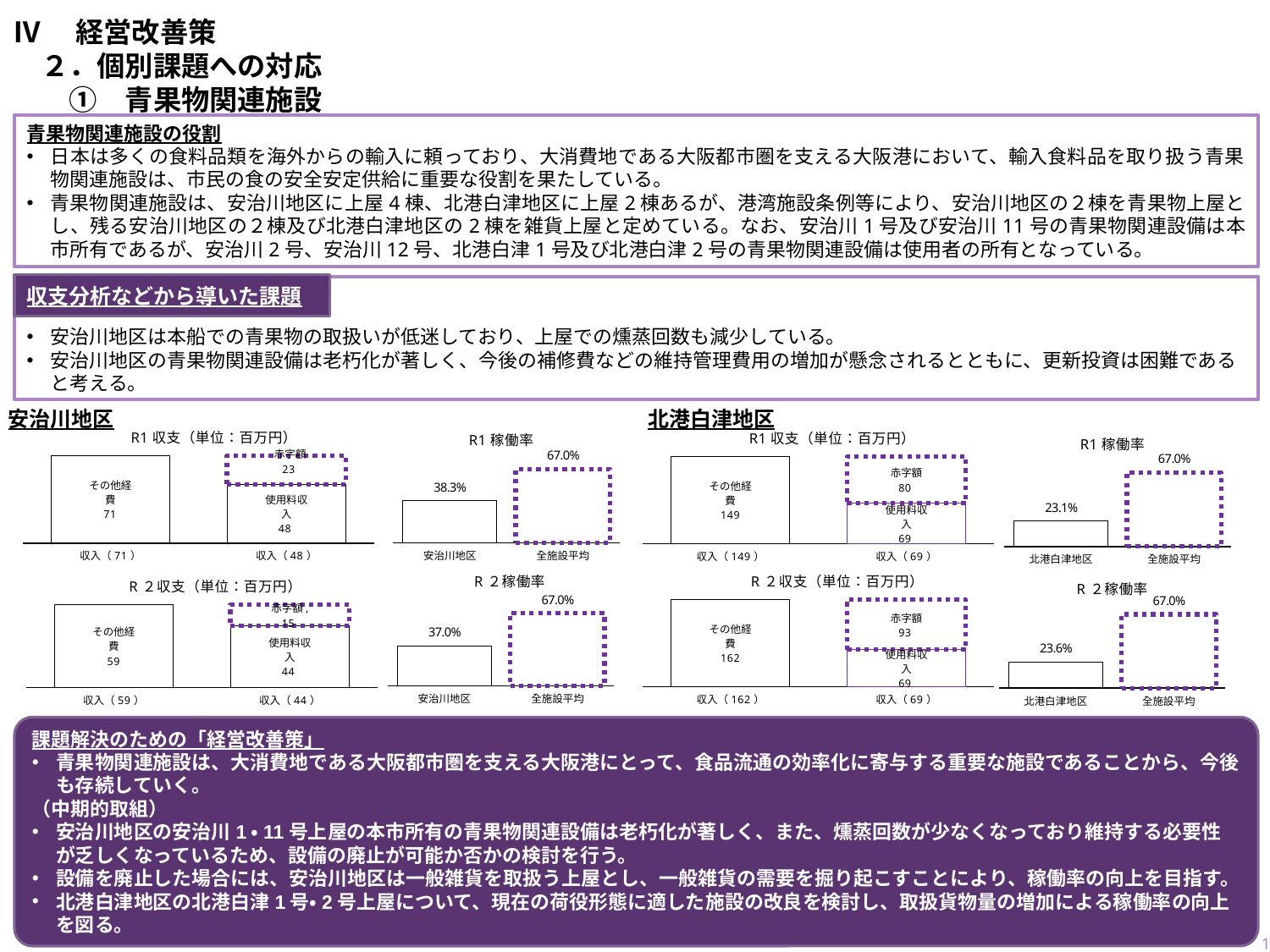
In the 北港白津地区 R２収支（単位：百万円） chart, what is the value of 赤字額? 93 In the 北港白津地区 R２稼働率 chart, what is the value for 北港白津地区? 23.6% In the 北港白津地区 R1 収支（単位：百万円） chart, what is the value of 使用料収入? 69 In the 北港白津地区 R1 稼働率 chart, what is the value for 北港白津地区? 23.1% In the 安治川地区 R２稼働率 chart, what is the value for 安治川地区? 37.0% In the 北港白津地区 R２稼働率 chart, which is larger, 北港白津地区 or 全施設平均? 全施設平均 In the 安治川地区 R1 収支（単位：百万円） chart, what is the value of その他経費? 71 In the 安治川地区 R1 稼働率 chart, what is the value for 全施設平均? 67.0% In the 安治川地区 R1 収支（単位：百万円） chart, what is the value of 赤字額? 23 In the 安治川地区 R1 稼働率 chart, what is the difference between 全施設平均 and 安治川地区? 28.7% In the 安治川地区 R1 稼働率 chart, what is the value for 安治川地区? 38.3% What kind of chart is the 安治川地区 R1 稼働率 chart? bar chart